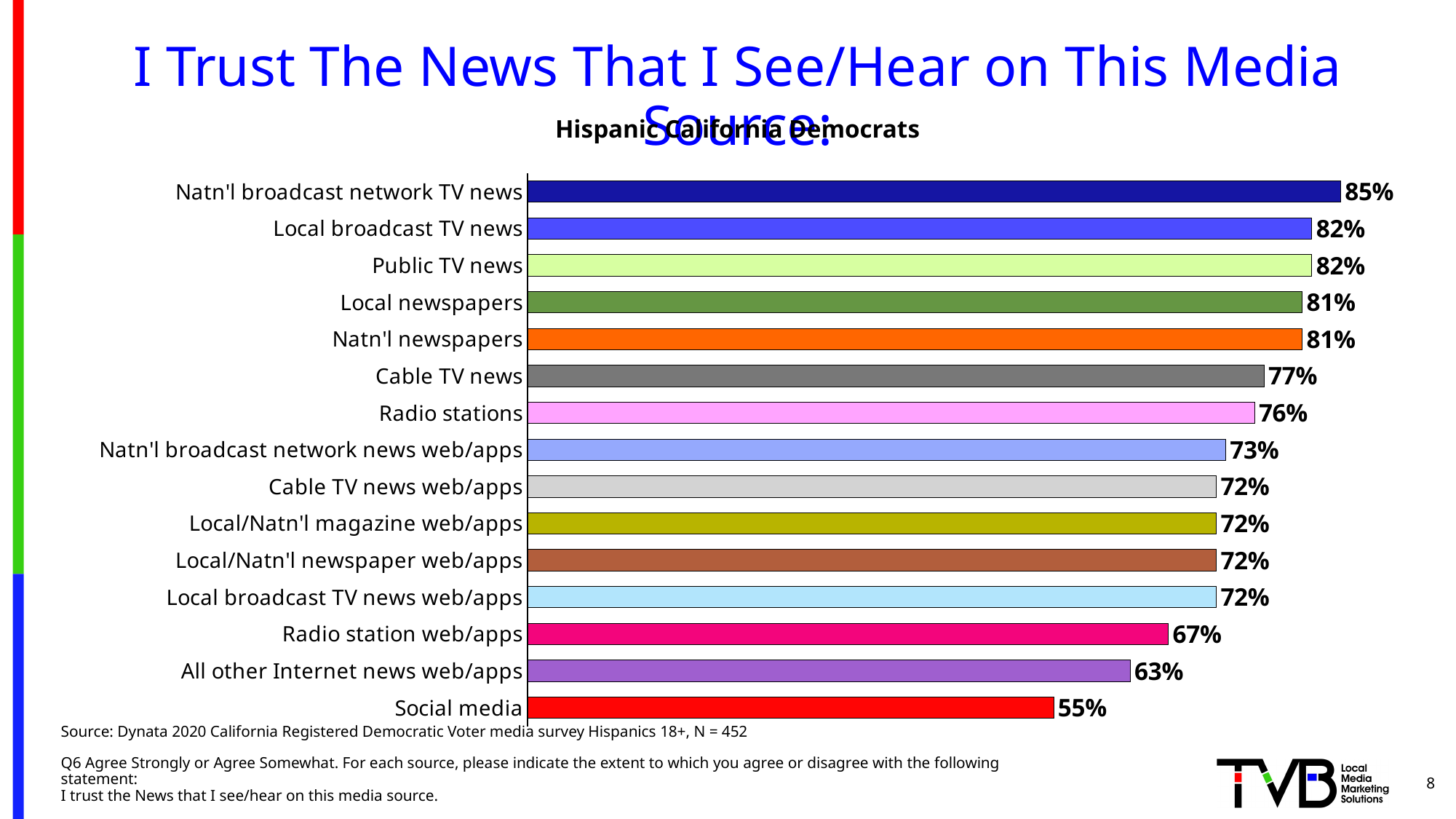
Which media source has the highest trust percentage? Natn'l broadcast network TV news What is the subtitle shown above the chart? Hispanic California Democrats Which media source has the lowest trust percentage? Social media What is the value shown for Radio station web/apps? 67% What is the difference between the values for Local broadcast TV news and Radio stations? 6 percentage points What is the value shown for Cable TV news? 77% What is the difference between the values for Natn'l broadcast network TV news and Social media? 30 percentage points What kind of chart is shown on the slide? Bar chart What is the value shown for Social media? 55% What percentage of Hispanic California Democrats trust the news on Natn'l broadcast network TV news? 85% How many media sources are shown in the chart? 15 Which is larger, the value for Cable TV news or the value for All other Internet news web/apps? Cable TV news